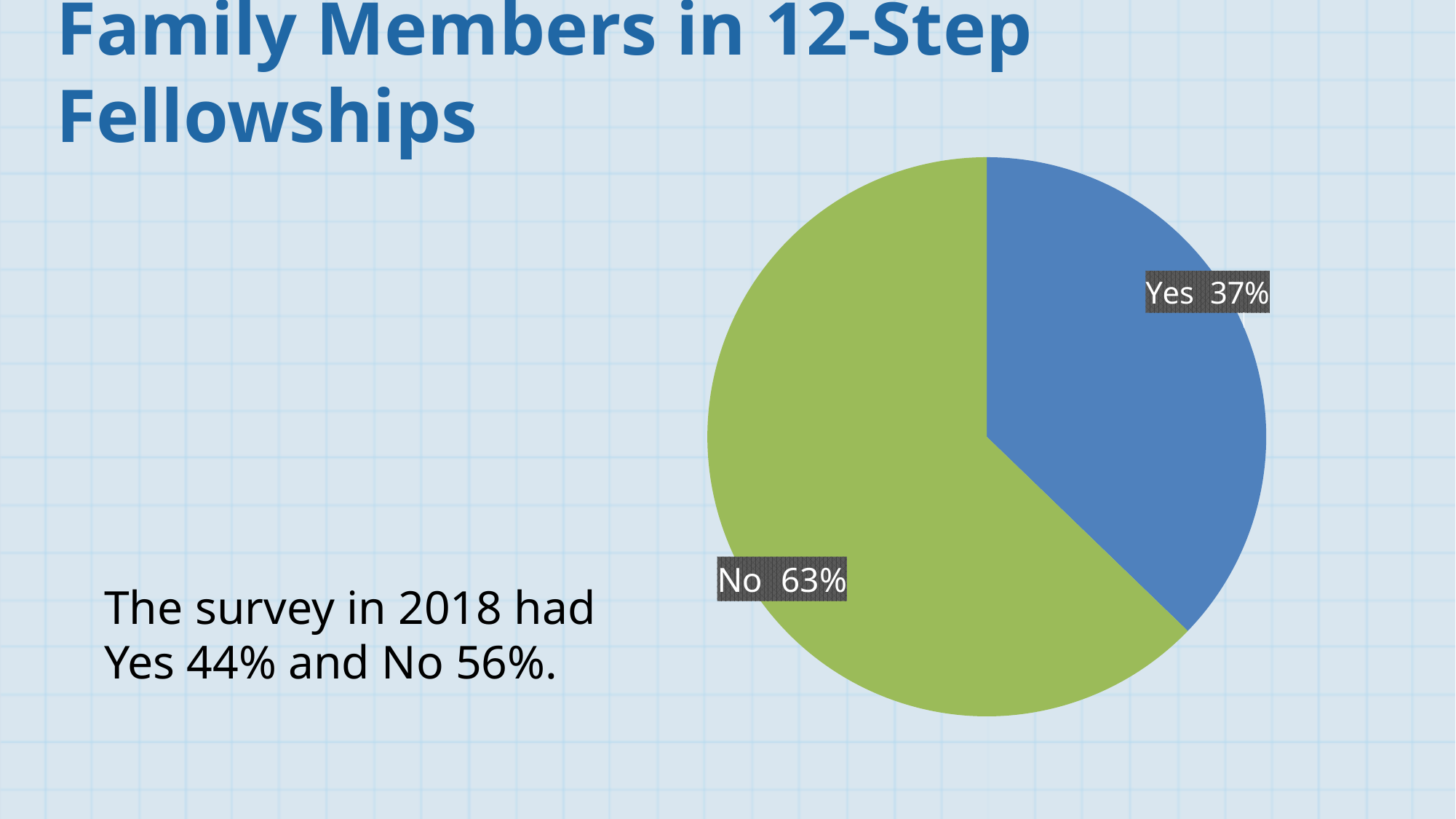
What is the difference in percentage points between the "No" slice and the "Yes" slice? 26 What colour is the "No" slice of the pie chart? Green What share of the pie does the "No" slice represent? 63% What colour is the "Yes" slice of the pie chart? Blue Which slice of the pie chart is the smallest? Yes What kind of chart is shown on the slide? Pie chart Which slice is larger, "Yes" or "No"? No What percentage of the pie chart is labelled "No"? 63% What percentage of the pie chart is labelled "Yes"? 37% How many slices does the pie chart have? 2 Which slice of the pie chart is the largest? No